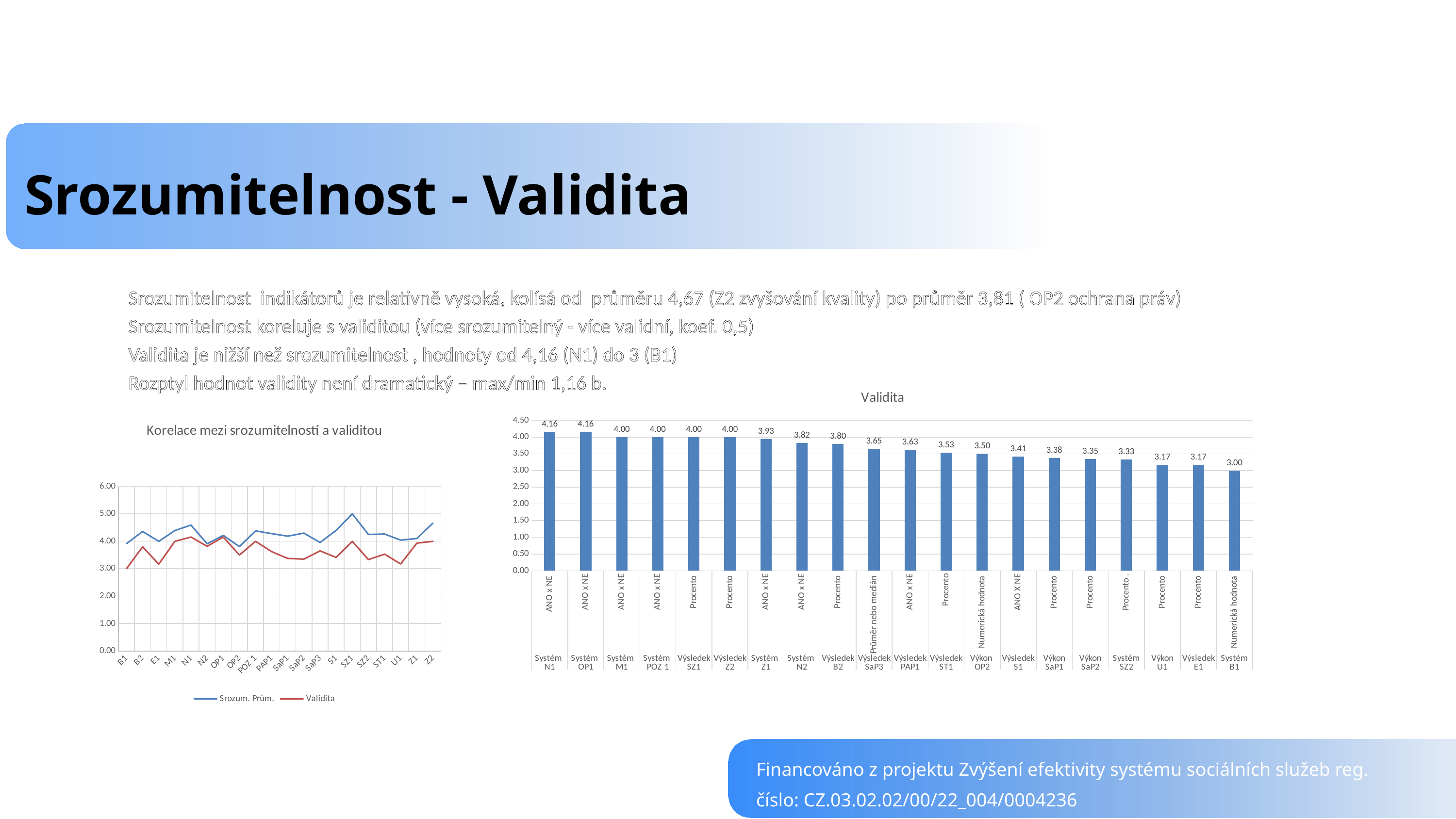
In the 'Validita' chart, what is the difference between the values for Systém N1 and Systém B1? 1.16 In the 'Validita' chart, do the values rise or fall from left to right? Fall In the 'Validita' chart, what is the value for Systém B1? 3.00 In the 'Validita' chart, which is larger: the value for Výsledek SaP3 or the value for Výsledek S1? Výsledek SaP3 How many series does the legend of the 'Korelace mezi srozumitelností a validitou' chart list? 2 In the 'Validita' chart, how many bars are plotted? 20 In the 'Validita' chart, what is the value for Systém Z1? 3.93 In the 'Korelace mezi srozumitelností a validitou' chart, which colour is the 'Validita' series drawn in? Red What kind of chart is 'Korelace mezi srozumitelností a validitou'? Line chart What kind of chart is the 'Validita' chart? Bar chart In the 'Validita' chart, which category has the lowest value? Systém B1 In the 'Validita' chart, what is the value for Výkon OP2? 3.50